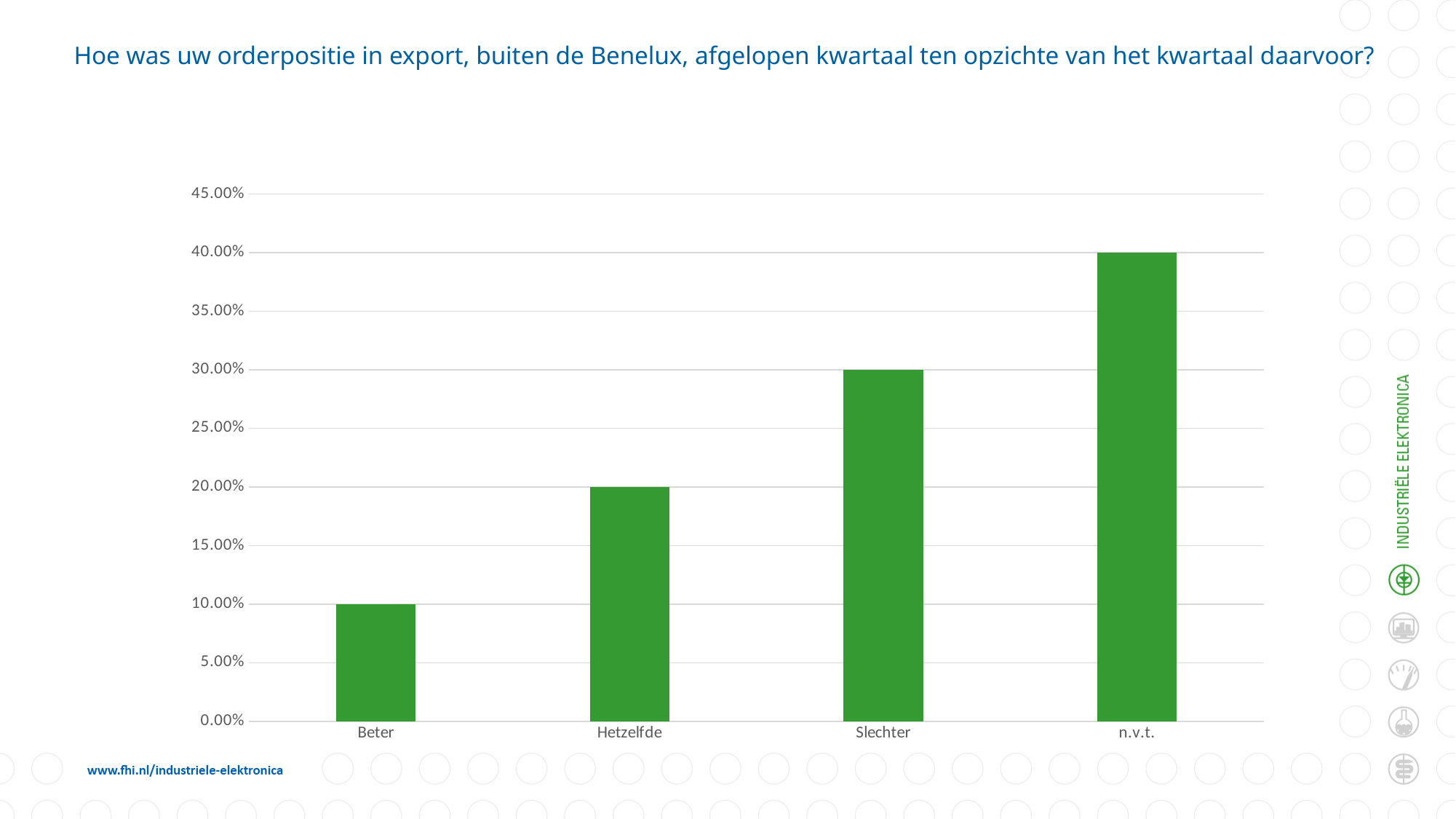
What is the value for Hetzelfde? 20.00% What is the difference between the values for n.v.t. and Beter? 30.00% What is the value for n.v.t.? 40.00% Which is larger, the value for Slechter or the value for Hetzelfde? Slechter What is the value for Beter? 10.00% Which category has the highest value? n.v.t. What kind of chart is shown on the slide? bar chart What is the value for Slechter? 30.00% Do the values rise or fall from left to right along the x axis? rise How many categories are shown on the x axis of the chart? 4 Which category has the lowest value? Beter What is the title of the chart? Hoe was uw orderpositie in export, buiten de Benelux, afgelopen kwartaal ten opzichte van het kwartaal daarvoor?